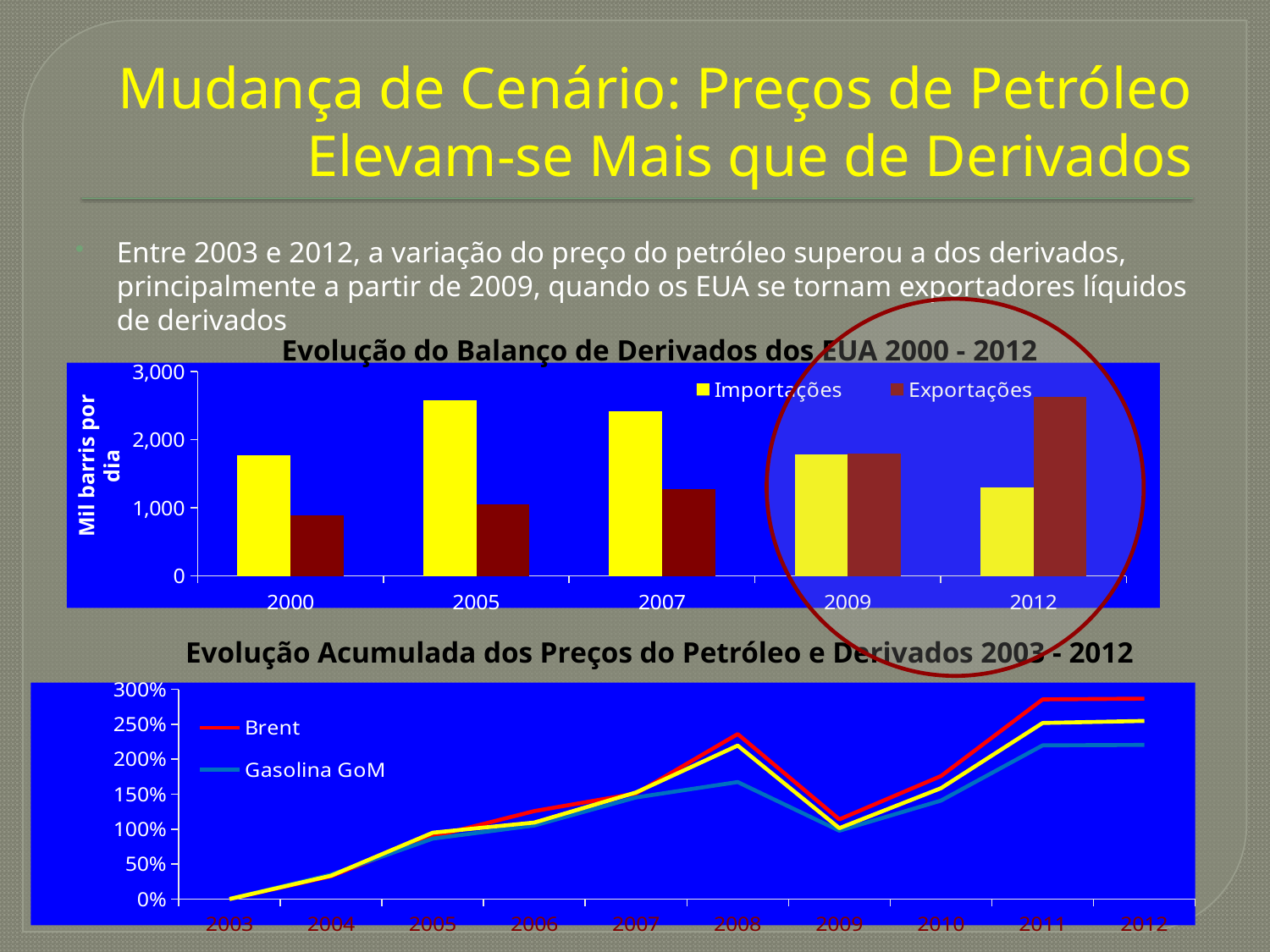
What kind of chart is 'Evolução do Balanço de Derivados dos EUA 2000 - 2012'? bar chart In the chart 'Evolução do Balanço de Derivados dos EUA 2000 - 2012', which is larger in 2012, Importações or Exportações? Exportações In the chart 'Evolução do Balanço de Derivados dos EUA 2000 - 2012', which year has the lowest Exportações value? 2000 In the chart 'Evolução do Balanço de Derivados dos EUA 2000 - 2012', is the Importações value for 2012 greater or less than 2,000? less In the chart 'Evolução do Balanço de Derivados dos EUA 2000 - 2012', what is the y-axis title? Mil barris por dia In the chart 'Evolução Acumulada dos Preços do Petróleo e Derivados 2003 - 2012', does the Brent line rise or fall from 2009 to 2011? rise In the chart 'Evolução do Balanço de Derivados dos EUA 2000 - 2012', which year has the highest Exportações value? 2012 In the chart 'Evolução do Balanço de Derivados dos EUA 2000 - 2012', how many series does the legend list? 2 In the chart 'Evolução do Balanço de Derivados dos EUA 2000 - 2012', how many years are shown on the x axis? 5 In the chart 'Evolução do Balanço de Derivados dos EUA 2000 - 2012', is the Importações value for 2005 greater or less than 2,000? greater In the chart 'Evolução Acumulada dos Preços do Petróleo e Derivados 2003 - 2012', how many years are shown on the x axis? 10 What kind of chart is 'Evolução Acumulada dos Preços do Petróleo e Derivados 2003 - 2012'? line chart